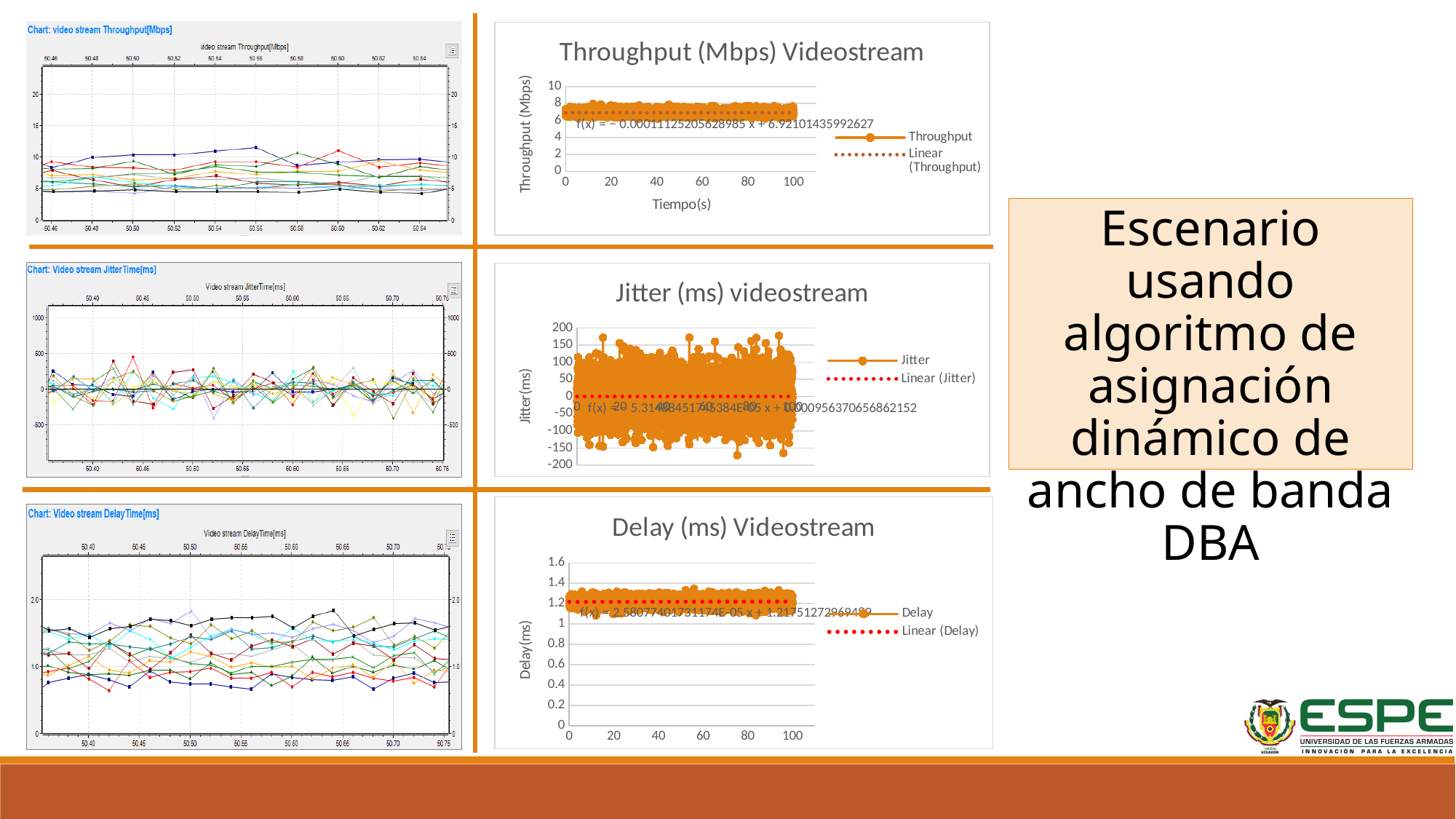
In the Delay (ms) Videostream chart, are the plotted delay values greater or less than 0.8 ms? greater In the Throughput (Mbps) Videostream chart, are the plotted throughput values greater or less than 4 Mbps? greater In the Jitter (ms) videostream chart, what are the two legend entries? Jitter and Linear (Jitter) What is the highest value shown on the y-axis of the Jitter (ms) videostream chart? 200 In the Delay (ms) Videostream chart, are the plotted delay values greater or less than 1.6 ms? less In the Throughput (Mbps) Videostream chart, how many entries does the legend list? 2 What is the lowest value shown on the y-axis of the Jitter (ms) videostream chart? -200 What kind of chart is the Throughput (Mbps) Videostream chart? scatter chart What is the highest tick value on the y-axis of the Delay (ms) Videostream chart? 1.6 In the Delay (ms) Videostream chart, how many series does the legend list? 2 What is the x-axis title of the Throughput (Mbps) Videostream chart? Tiempo(s)